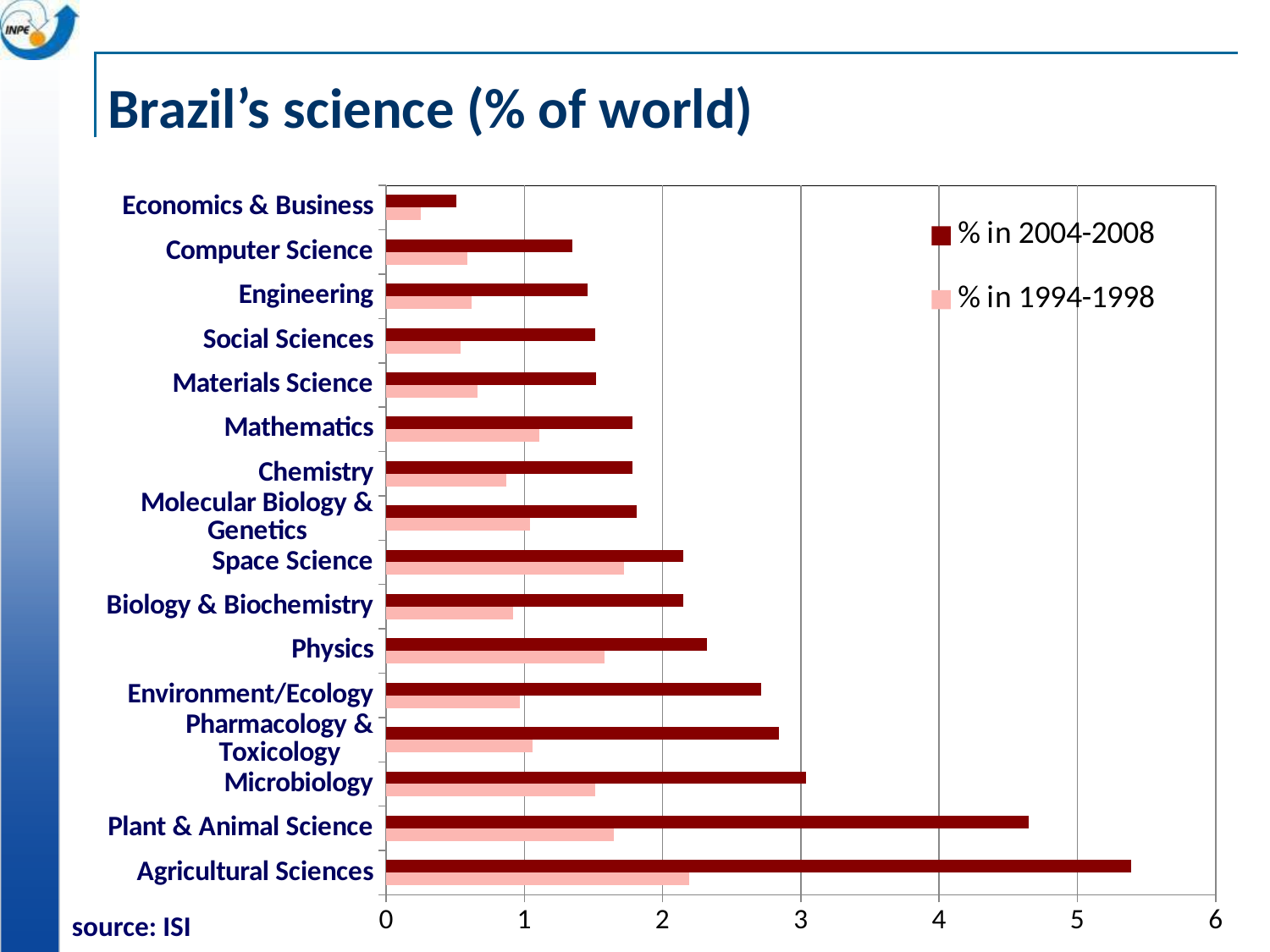
For % in 2004-2008, which is larger: Environment/Ecology or Physics? Environment/Ecology What is the source cited for the chart data? ISI Is the value for Economics & Business in 2004-2008 greater or less than 1? less What kind of chart is shown on the slide? bar chart Which field has the lowest value for % in 2004-2008? Economics & Business Is the value for Plant & Animal Science in 2004-2008 greater or less than 4? greater How many research fields (categories) are plotted on the chart? 16 Is the value for Space Science in 1994-1998 greater or less than 1? greater Which field has the highest value for % in 2004-2008? Agricultural Sciences How many series does the legend list? 2 Which field has the highest value for % in 1994-1998? Agricultural Sciences